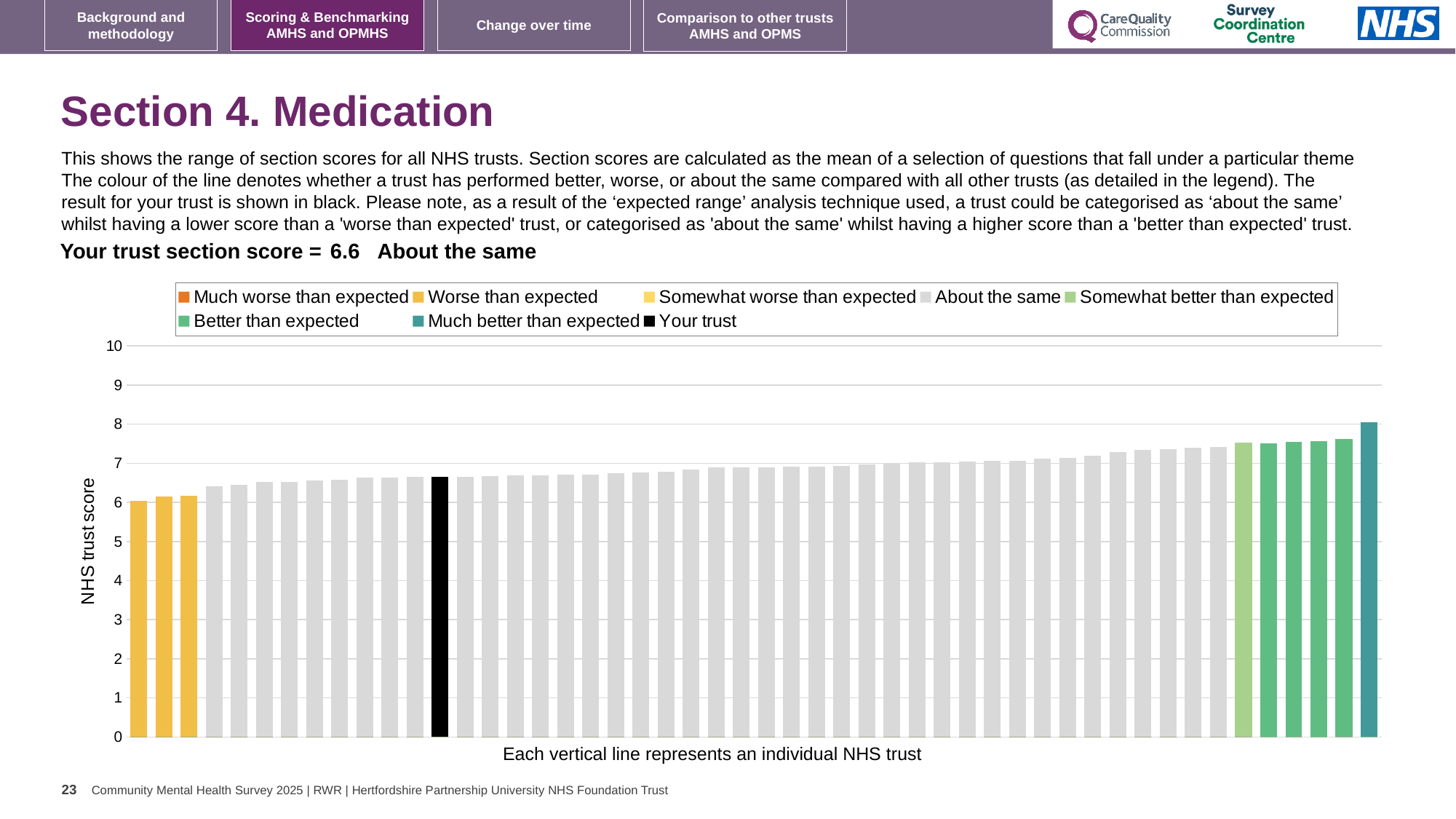
What is the section score for your trust shown on the slide? 6.6 Is the value of the shortest bar greater or less than 7? less Is the value of the tallest bar greater or less than 7? greater What kind of chart is shown on the slide? bar chart What is the label on the vertical axis of the chart? NHS trust score Which is larger: the black 'Your trust' bar or the teal 'Much better than expected' bar? the teal 'Much better than expected' bar How many entries does the chart legend list? 8 How many bars are coloured as 'Worse than expected'? 3 Do the bar values rise or fall from left to right along the x axis? rise Which category does your trust fall into according to the slide? About the same Is the value of the black 'Your trust' bar greater or less than 5? greater How many bars are coloured as 'Much better than expected'? 1